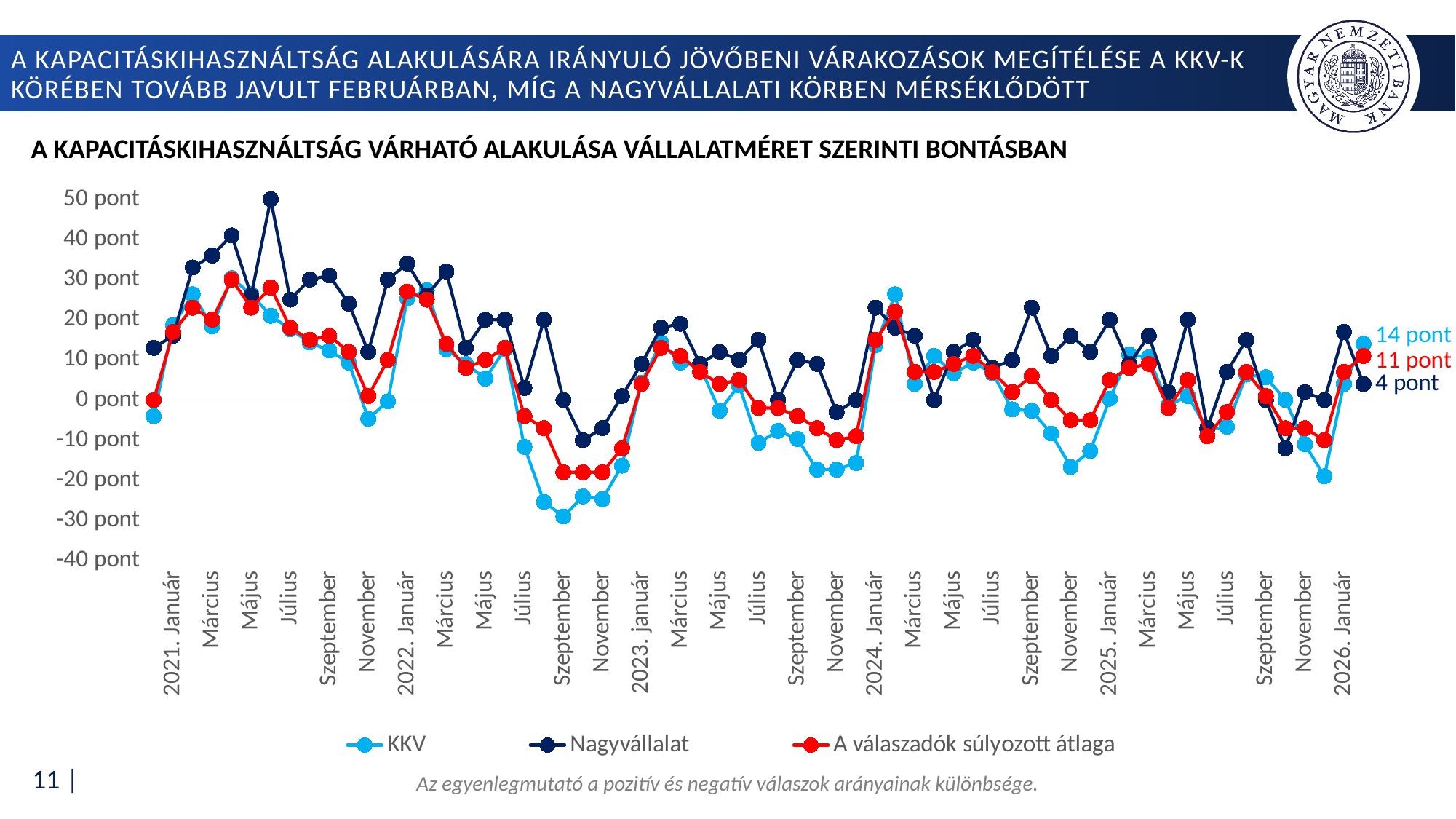
What is the latest value of the 'A válaszadók súlyozott átlaga' series, as labelled at the end of the line? 11 pont What kind of chart is shown on the slide? line chart Which series has the lowest value at the latest labelled point? Nagyvállalat What is the difference between the latest labelled values of the KKV and Nagyvállalat series? 10 pont How many series does the legend list? 3 What is the title of the chart? A kapacitáskihasználtság várható alakulása vállalatméret szerinti bontásban Is the lowest value reached by the KKV series greater or less than -20 pont? less What is the latest value of the Nagyvállalat series, as labelled at the end of the line? 4 pont Is the highest value reached by the Nagyvállalat series greater or less than 40 pont? greater What is the latest value of the KKV series, as labelled at the end of the line? 14 pont Which series has the highest value at the latest labelled point? KKV At the latest labelled point, which is larger: the KKV value or the Nagyvállalat value? KKV